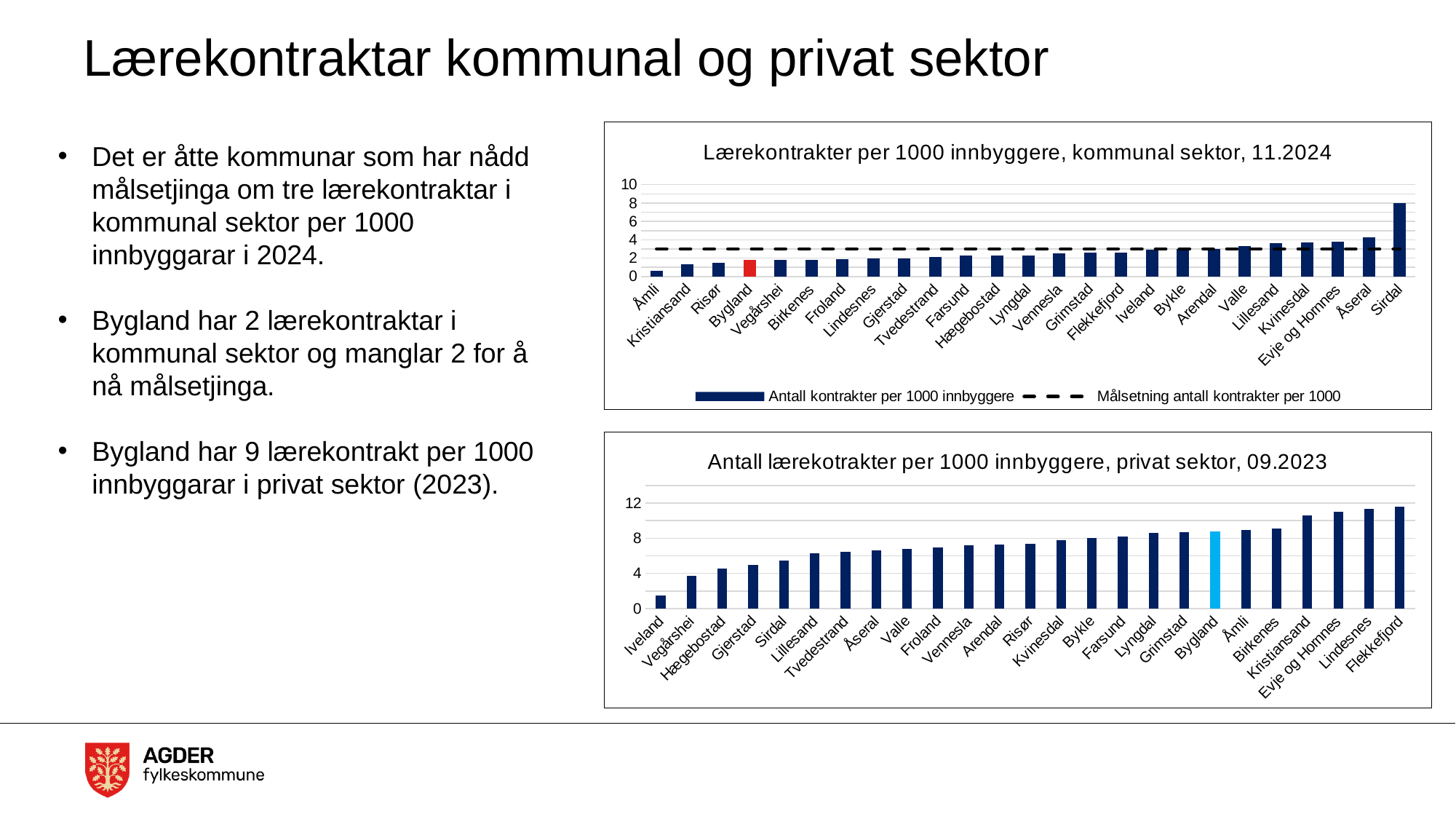
In the top chart (kommunal sektor), is the value for Sirdal greater or less than 6? greater In the top chart (kommunal sektor), which bar is coloured red? Bygland In the bottom chart (privat sektor, 09.2023), which municipality has the lowest value? Iveland What kind of chart is the top chart, 'Lærekontrakter per 1000 innbyggere, kommunal sektor, 11.2024'? Combination bar and line chart (bars with a dashed target line) In the top chart (kommunal sektor), which municipality has the highest number of contracts per 1000 inhabitants? Sirdal In the bottom chart (privat sektor, 09.2023), is the value for Kristiansand greater or less than 8? greater In the top chart (kommunal sektor), which municipality has the lowest number of contracts per 1000 inhabitants? Åmli In the top chart (kommunal sektor), is the value for Åmli greater or less than 2? less How many series does the legend of the top chart (kommunal sektor) list? 2 In the bottom chart (privat sektor, 09.2023), do the values rise or fall from left to right along the x axis? Rise In the bottom chart (privat sektor, 09.2023), which municipality has the highest value? Flekkefjord How many municipalities are shown on the x axis of the top chart (kommunal sektor)? 25